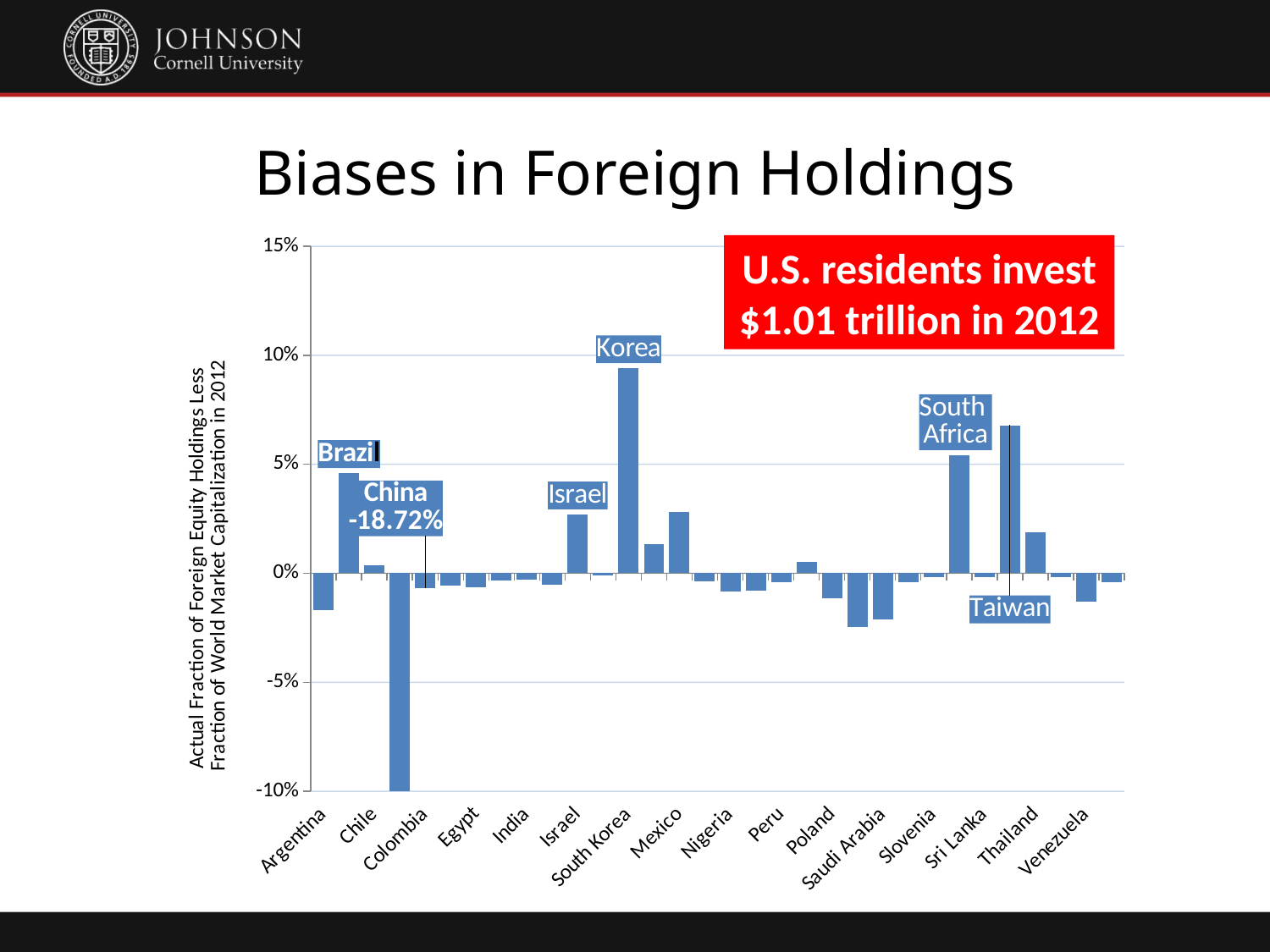
Is the value for Israel greater or less than 0%? greater Is the value for Taiwan greater or less than 5%? greater What does the red box on the chart say? U.S. residents invest $1.01 trillion in 2012 Which is larger, the value for Korea or the value for Taiwan? Korea Which labelled country has the highest bar? Korea What is the title of the slide containing the chart? Biases in Foreign Holdings Is the value for Brazil greater or less than 5%? less What kind of chart is shown on the slide? bar chart Which labelled country has the lowest value? China What is the value printed for China? -18.72%